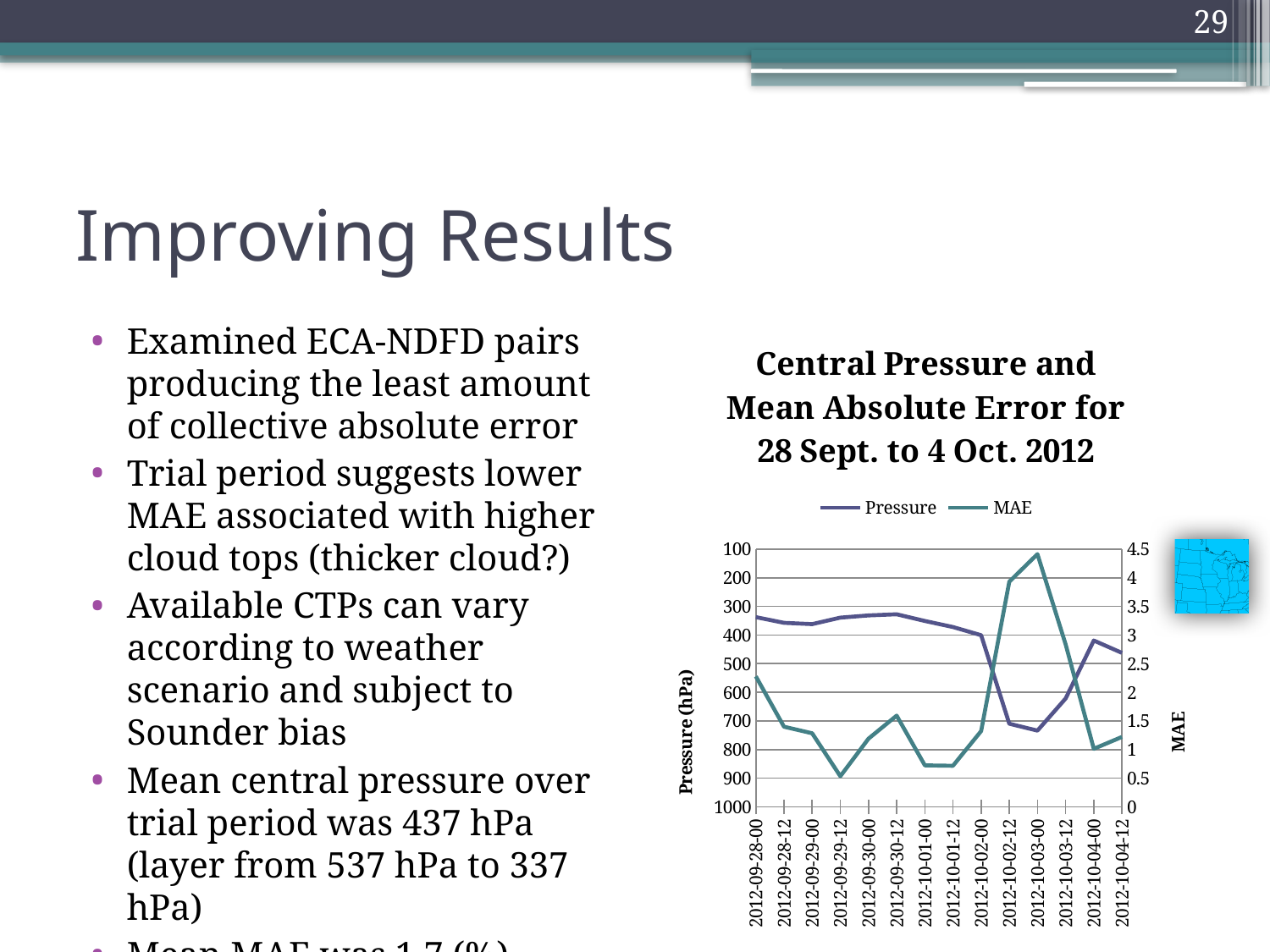
Does the MAE series rise or fall between 2012-10-03-00 and 2012-10-04-00? Fall What is the title of the chart? Central Pressure and Mean Absolute Error for 28 Sept. to 4 Oct. 2012 What are the two series named in the legend? Pressure and MAE Which is larger, the MAE value at 2012-10-02-12 or at 2012-09-28-00? 2012-10-02-12 How many series does the chart legend list? 2 At which time point does the MAE series reach its highest value? 2012-10-03-00 How many time points are shown along the x axis? 14 Is the Pressure value at 2012-09-28-00 greater or less than 400 hPa? less At which time point does the MAE series reach its lowest value? 2012-09-29-12 What kind of chart is shown on the slide? Line chart Is the MAE value at 2012-09-29-12 greater or less than 1? less Is the MAE value at 2012-10-03-00 greater or less than 4? greater